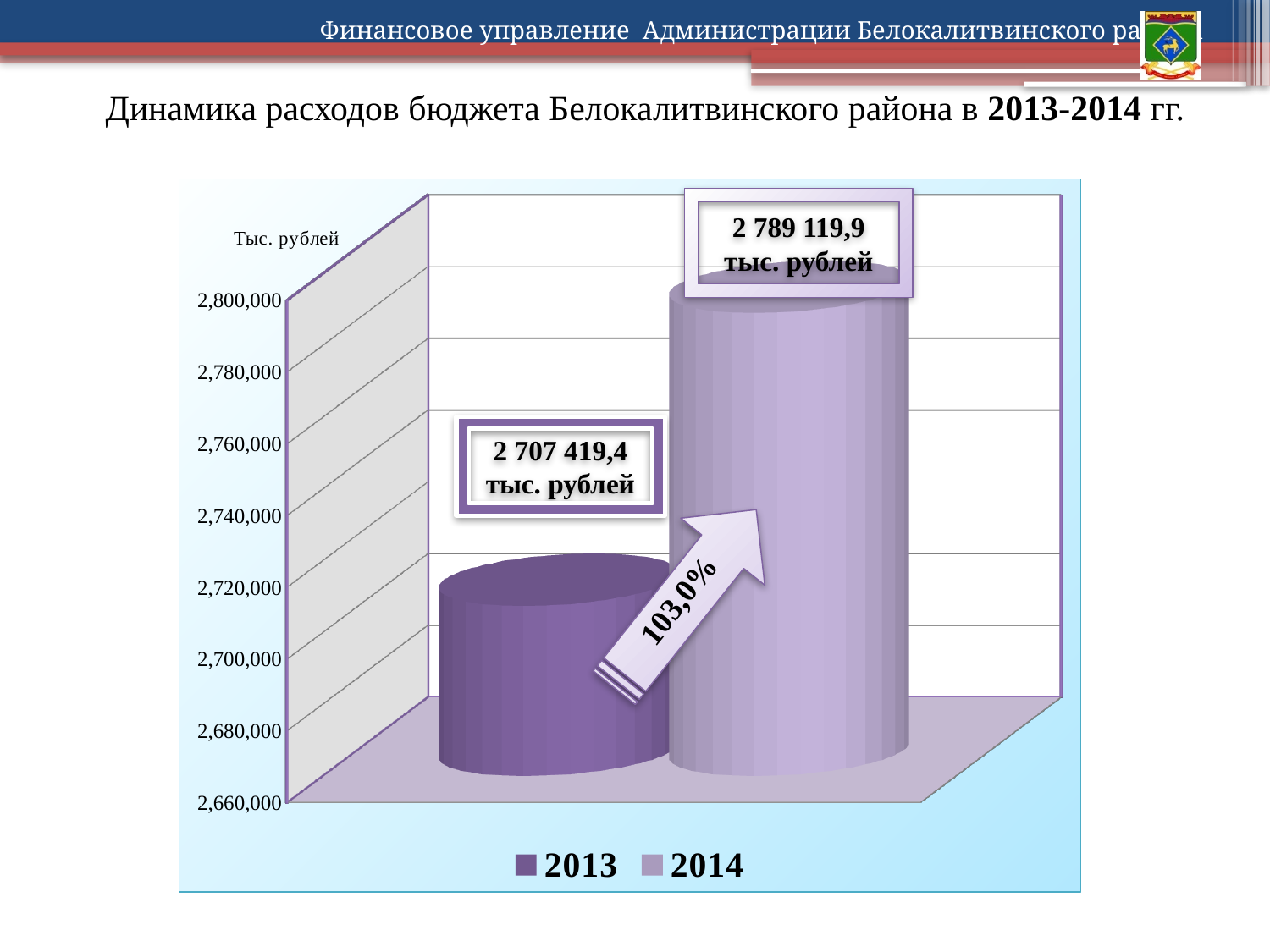
Which year shows the lowest expenditure value? 2013 Which year has the higher expenditure value, 2013 or 2014? 2014 Is the value for 2014 greater or less than 2,780,000? greater What percentage is printed on the arrow between the two bars? 103,0% How many series does the legend list? 2 Which year shows the highest expenditure value? 2014 What is the budget expenditure value shown for 2013? 2 707 419,4 тыс. рублей Is the value for 2013 greater or less than 2,720,000? less What is the budget expenditure value shown for 2014? 2 789 119,9 тыс. рублей Do the expenditure values rise or fall from 2013 to 2014? rise What kind of chart is shown on the slide? bar chart What is the difference between the 2014 and 2013 expenditure values, in тыс. рублей? 81 700,5